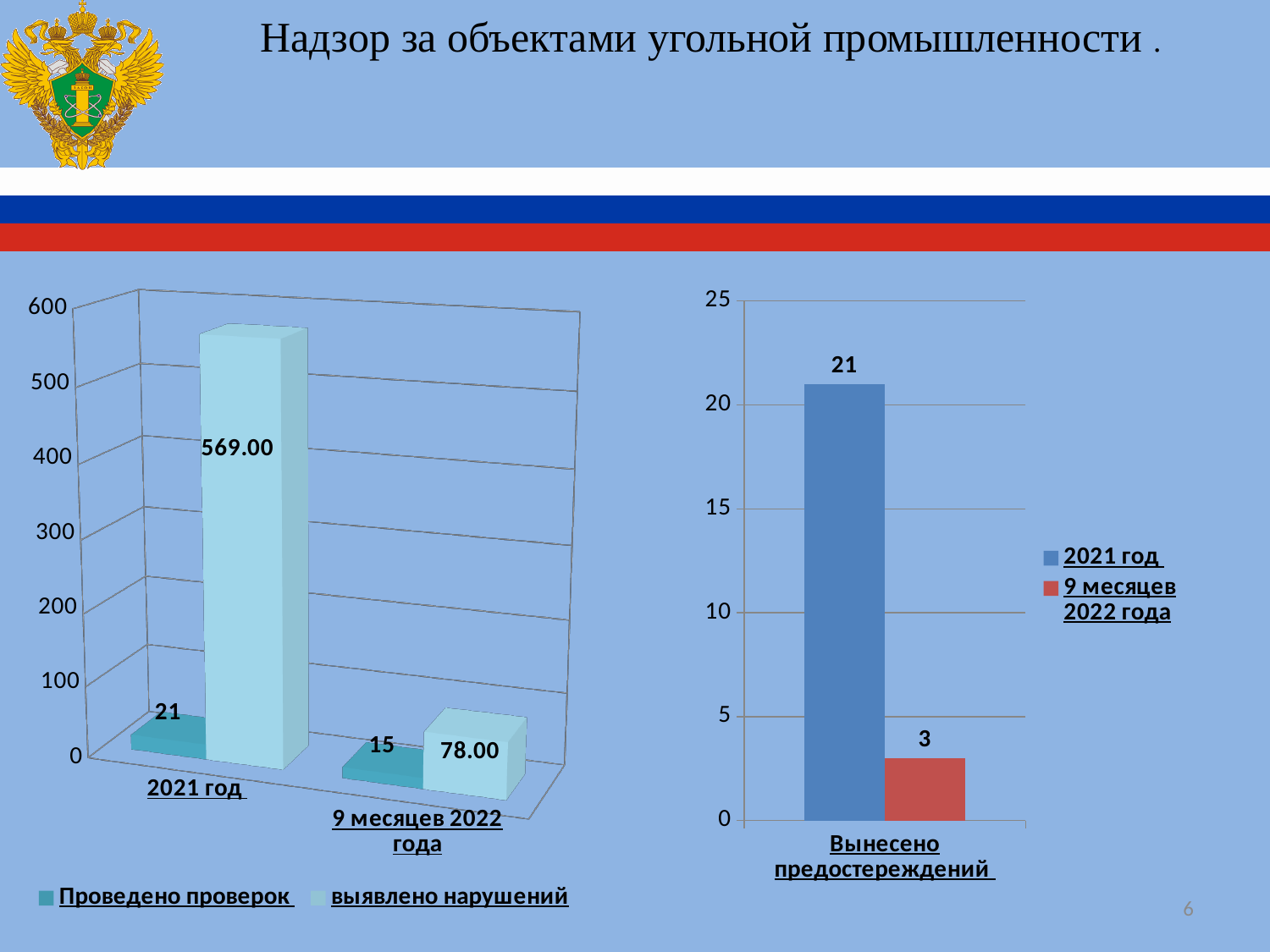
What kind of chart is the right chart? Bar chart In the left chart, what is the value of 'выявлено нарушений' for '9 месяцев 2022 года'? 78.00 In the right chart, what is the difference between the '2021 год' value and the '9 месяцев 2022 года' value? 18 In the right chart, what is the value for '2021 год' under 'Вынесено предостережений'? 21 In the left chart, which category has the higher value for 'Проведено проверок'? 2021 год In the right chart, what colour is the bar for '9 месяцев 2022 года'? Red In the left chart, how many series does the legend list? 2 In the left chart, what is the difference between 'выявлено нарушений' in '2021 год' and in '9 месяцев 2022 года'? 491.00 In the right chart, what is the value for '9 месяцев 2022 года'? 3 In the left chart, what is the value of 'Проведено проверок' for '9 месяцев 2022 года'? 15 In the left chart, how many categories are shown on the x axis? 2 In the left chart, what is the value of 'выявлено нарушений' for '2021 год'? 569.00